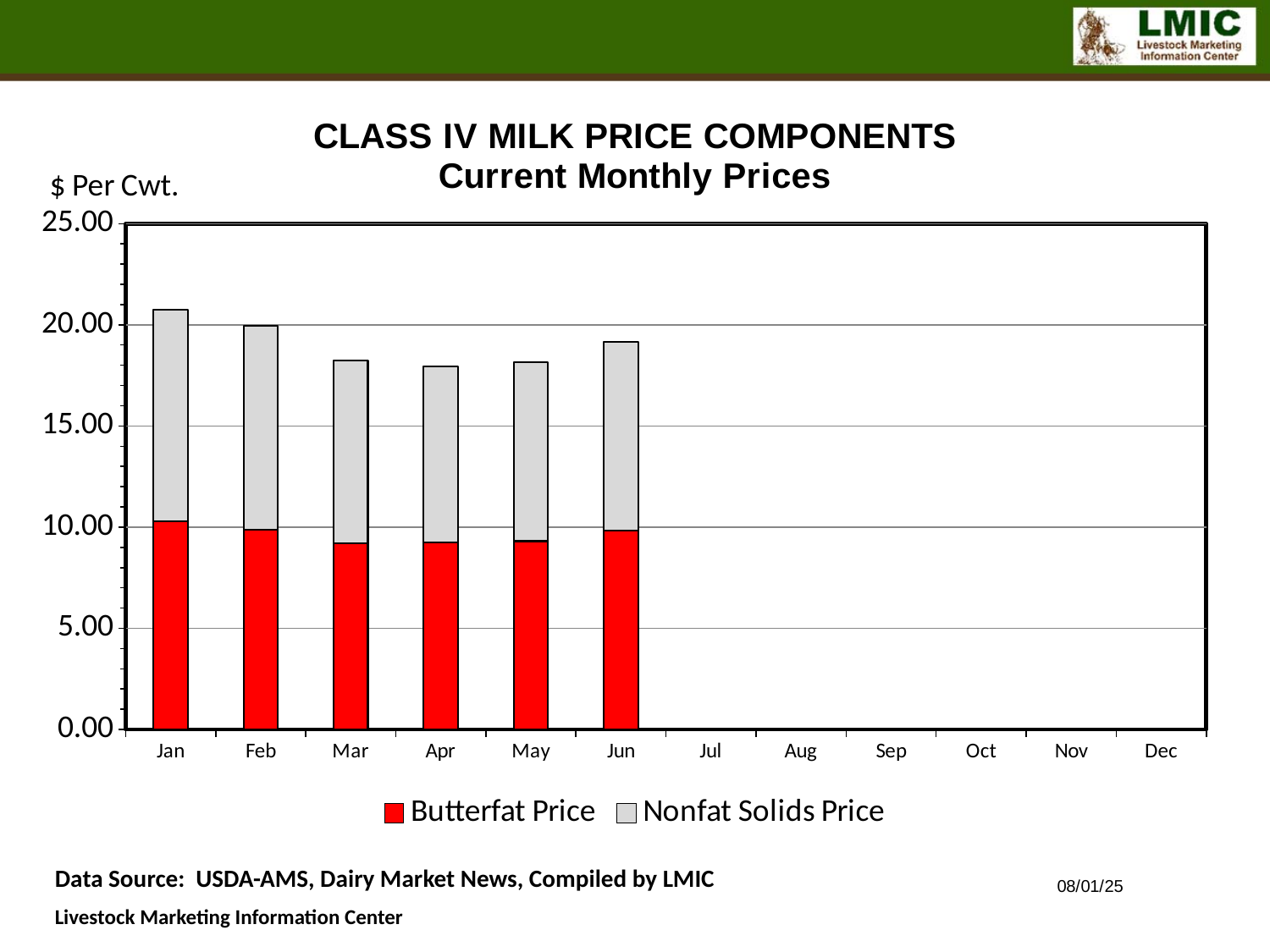
Which is larger, the total stacked bar for Jan or for Jun? Jan What kind of chart is shown on the slide? Stacked bar chart Which month has the highest Butterfat Price? Jan Is the total stacked value for Jan greater or less than 20.00? greater What unit label is shown on the y axis? $ Per Cwt. Is the Butterfat Price for Mar greater or less than 10.00? less How many months have bars plotted on the chart? 6 Is the Butterfat Price for Jan greater or less than 10.00? greater How many month categories are shown along the x axis? 12 How many series does the legend list? 2 Which month has the highest total Class IV milk price (stacked bar)? Jan